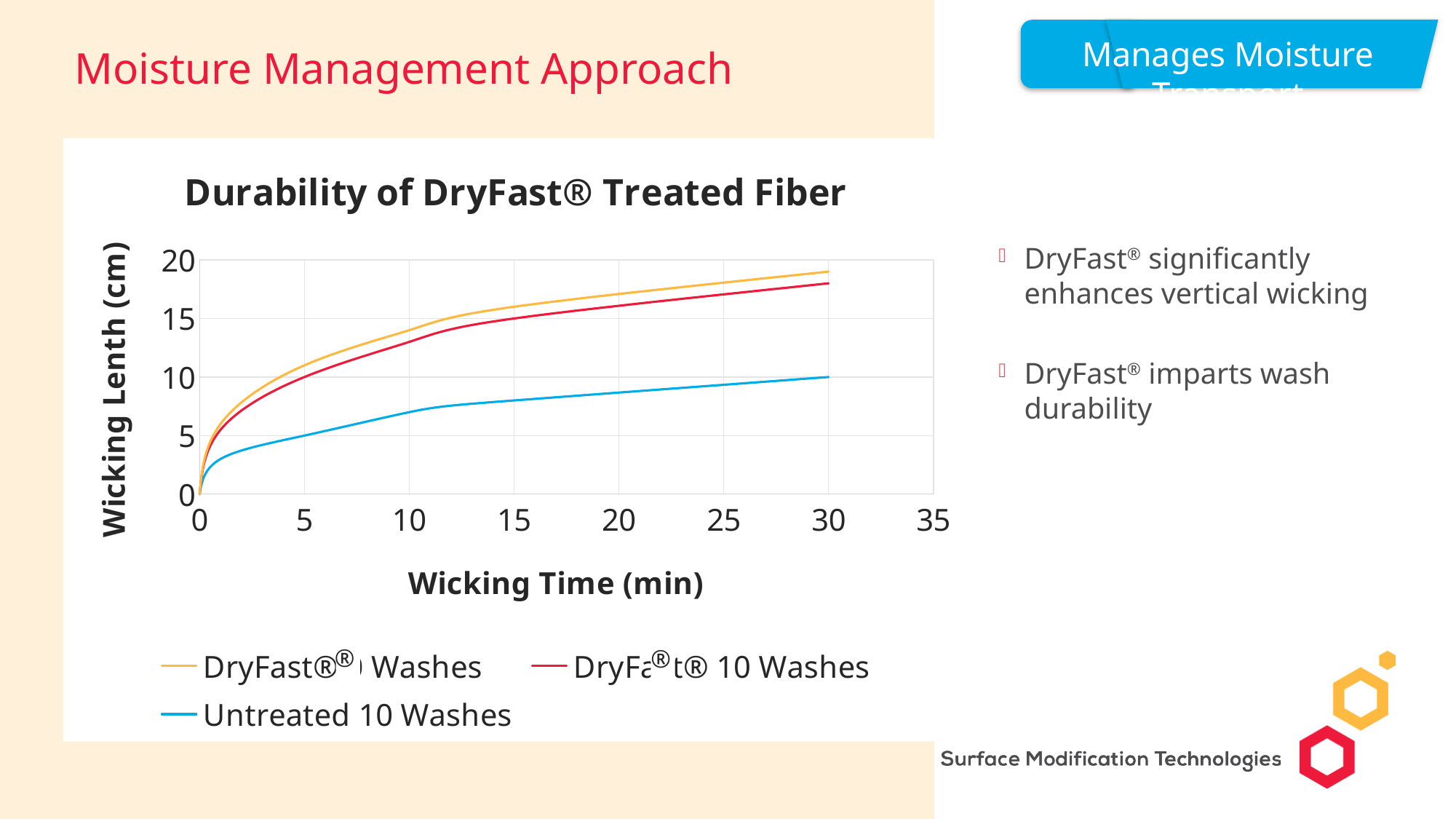
Is the value for DryFast® 10 Washes at 30 minutes greater or less than 15? greater Is the value for DryFast® 10 Washes at 5 minutes greater or less than 5? greater Is the value for Untreated 10 Washes at 10 minutes greater or less than 10? less What is the title of the chart? Durability of DryFast® Treated Fiber Which series has the lowest wicking length across the chart? Untreated 10 Washes At 30 minutes, which is larger: DryFast® 10 Washes or Untreated 10 Washes? DryFast® 10 Washes What is the label of the x axis of the chart? Wicking Time (min) Do the wicking length values rise or fall as wicking time increases? rise What kind of chart is shown on the slide? line chart How many series does the chart legend list? 3